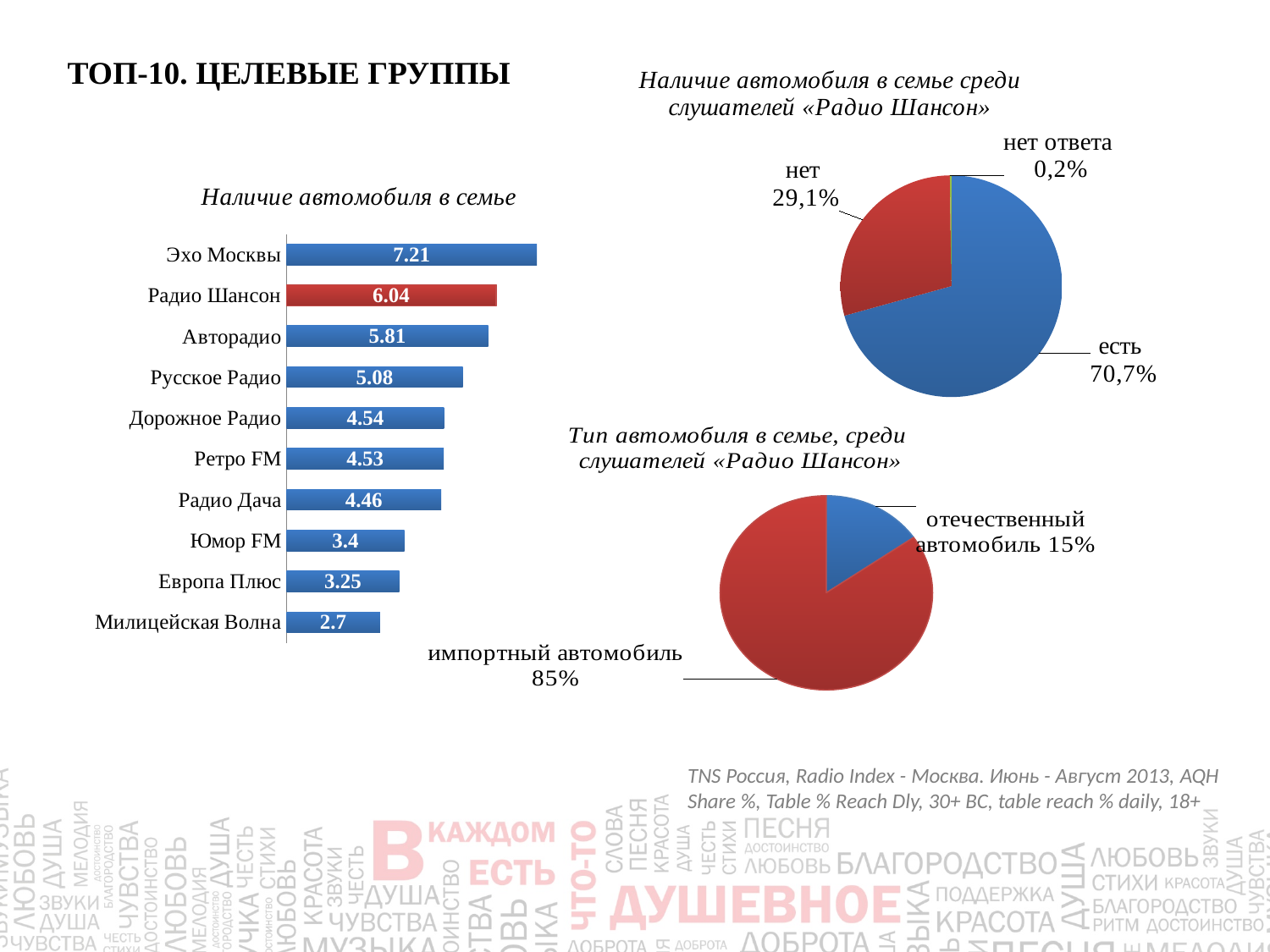
In the pie chart "Наличие автомобиля в семье среди слушателей «Радио Шансон»", what share is labelled "есть"? 70,7% In the bar chart "Наличие автомобиля в семье", what is the value for Дорожное Радио? 4.54 In the bar chart "Наличие автомобиля в семье", what is the value for Радио Шансон? 6.04 What type of chart is "Наличие автомобиля в семье"? Bar chart In the pie chart "Тип автомобиля в семье, среди слушателей «Радио Шансон»", what share is labelled "импортный автомобиль"? 85% How many stations are shown in the bar chart "Наличие автомобиля в семье"? 10 In the bar chart "Наличие автомобиля в семье", which bar is coloured red rather than blue? Радио Шансон In the bar chart "Наличие автомобиля в семье", what is the difference between the values for Эхо Москвы and Радио Шансон? 1.17 In the bar chart "Наличие автомобиля в семье", which station has the highest value? Эхо Москвы In the bar chart "Наличие автомобиля в семье", which has a larger value, Авторадио or Русское Радио? Авторадио In the pie chart "Наличие автомобиля в семье среди слушателей «Радио Шансон»", what share is labelled "нет ответа"? 0,2% In the bar chart "Наличие автомобиля в семье", which station has the lowest value? Милицейская Волна